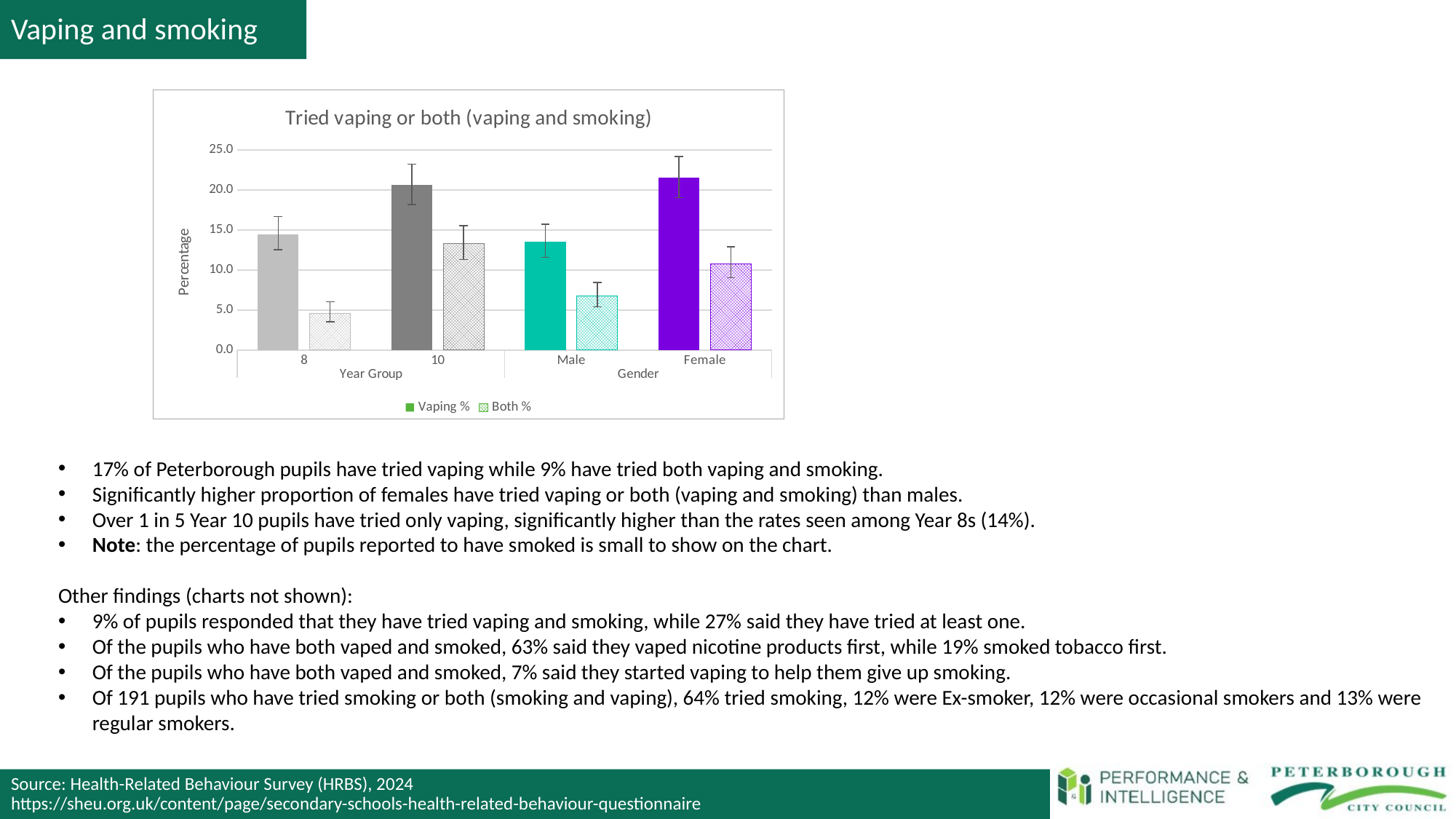
Which is larger, the Vaping % value for Male or for Female? Female How many series does the chart legend list? 2 What is the title of the chart? Tried vaping or both (vaping and smoking) Is the Both % value for Male greater or less than 10? less How many categories are shown along the x axis of the chart? 4 Is the Both % value for Year Group 10 greater or less than 10? greater What is the label on the vertical axis of the chart? Percentage Is the Vaping % value for Female greater or less than 20? greater Which is larger, the Both % value for Year Group 8 or for Year Group 10? 10 What kind of chart is shown on the slide? bar chart Which category has the lowest Both % value? 8 Which category has the highest Both % value? 10